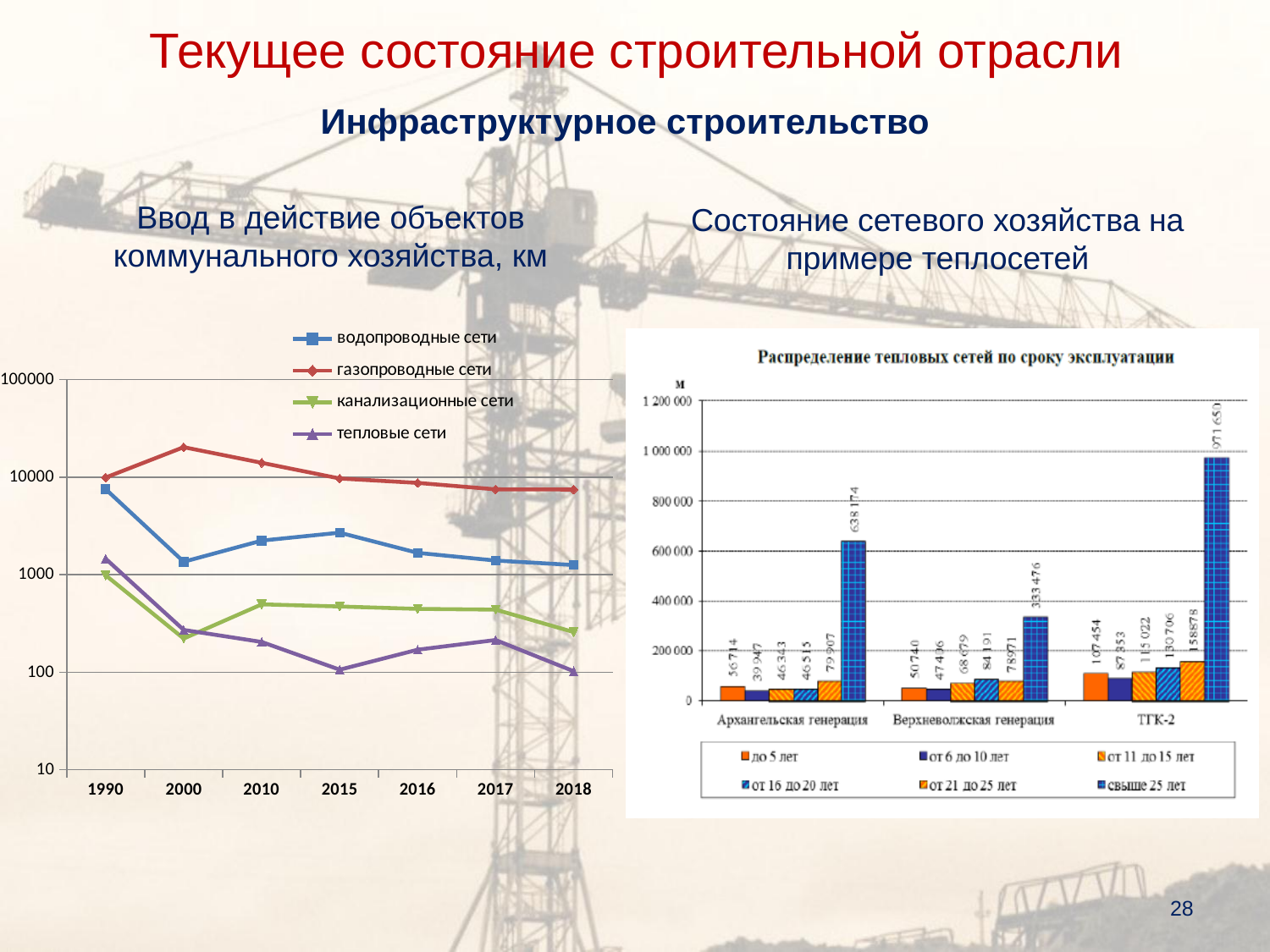
In the right chart, which category has the highest 'свыше 25 лет' bar? ТГК-2 What kind of chart is the right chart, 'Распределение тепловых сетей по сроку эксплуатации'? bar chart How many series does the legend of the right chart list? 6 In the left chart, which is larger in 2018: канализационные сети or тепловые сети? канализационные сети How many years are shown on the x axis of the left chart? 7 In the left chart, does the водопроводные сети series rise or fall from 1990 to 2000? fall In the left chart, which series has the highest value in 2018? газопроводные сети In the right chart, what is the value for 'свыше 25 лет' for ТГК-2? 971 650 What kind of chart is the left chart, 'Ввод в действие объектов коммунального хозяйства, км'? line chart In the left chart, is the value for газопроводные сети in 2000 greater or less than 10000? greater In the left chart, is the value for тепловые сети in 2015 greater or less than 1000? less How many series does the legend of the left chart list? 4